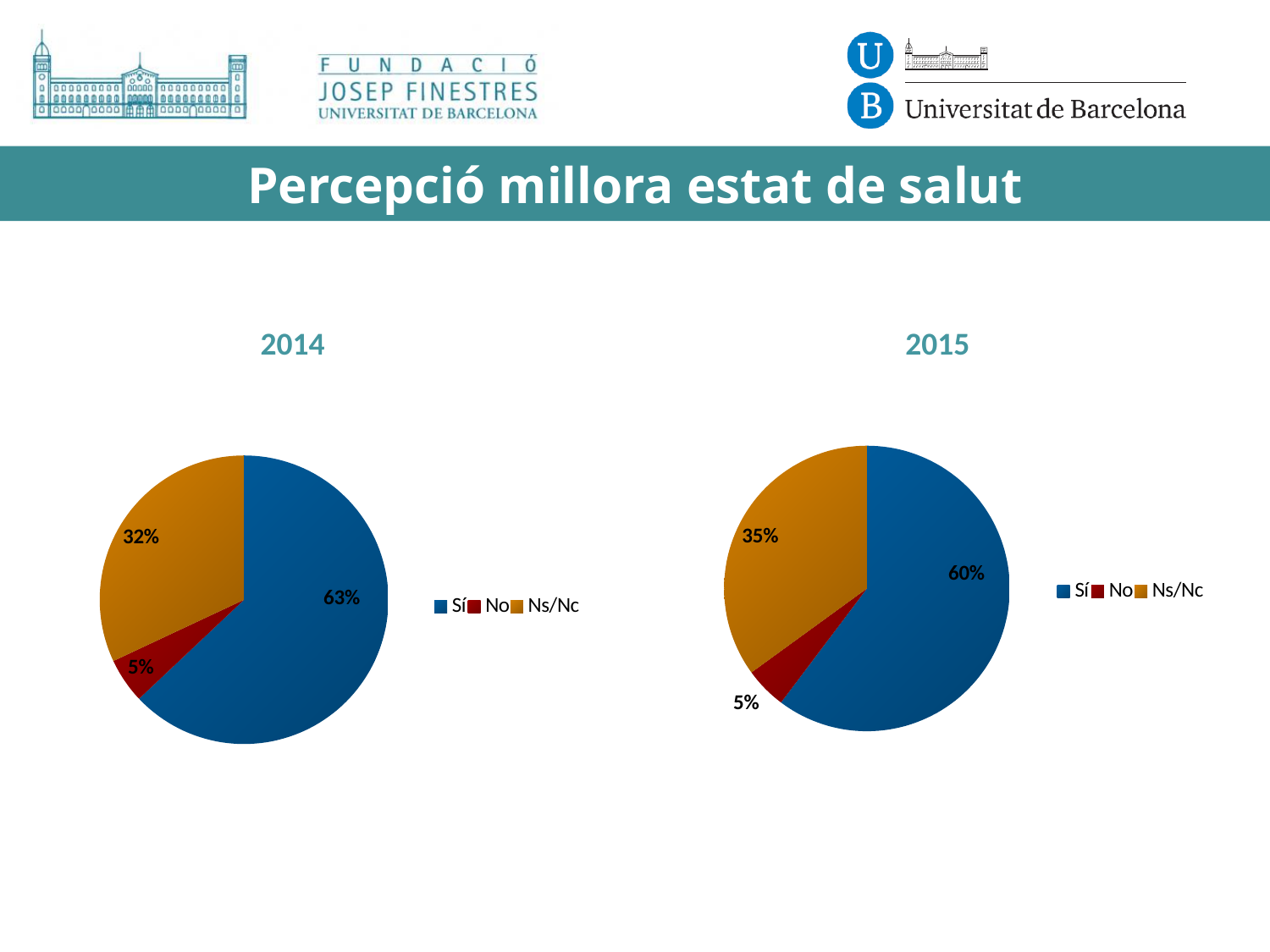
In the 2014 chart, what percentage is shown for Sí? 63% In the 2015 chart, what percentage is shown for Sí? 60% In the 2014 chart, what percentage is shown for No? 5% In the 2015 chart, what percentage is shown for Ns/Nc? 35% What kind of chart is the 2014 chart? Pie chart What colour is the Sí slice in the 2015 chart? Blue What is the difference between the Sí share in the 2014 chart and the Sí share in the 2015 chart? 3% Which is larger: the Ns/Nc share in the 2014 chart or the Ns/Nc share in the 2015 chart? 2015 In the 2014 chart, which category has the largest slice? Sí What share of the 2014 pie does the Ns/Nc slice represent? 32% How many slices does the 2015 chart have? 3 In the 2015 chart, which category has the smallest slice? No